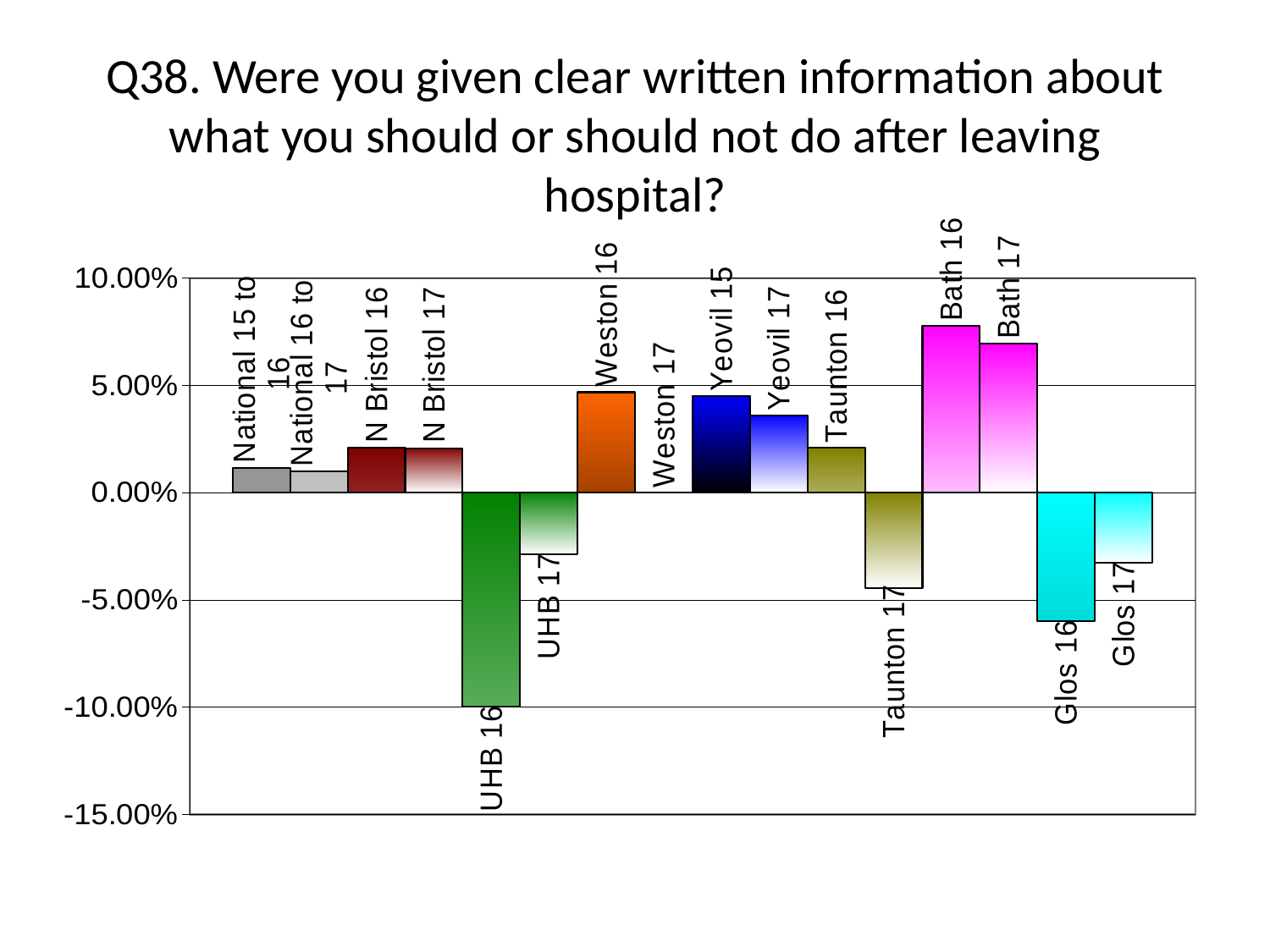
Is the value for Glos 16 greater or less than -5.00%? less Is the value for UHB 17 greater or less than 0.00%? less Is the value for Bath 16 greater or less than 5.00%? greater Which is larger, the value for Bath 17 or the value for N Bristol 17? Bath 17 What is the title of the chart? Q38. Were you given clear written information about what you should or should not do after leaving hospital? How many categories (bars) are plotted on the chart? 16 Which is lower, the value for UHB 16 or the value for Taunton 17? UHB 16 Which category has the highest value on the chart? Bath 16 Which category has the lowest value on the chart? UHB 16 Which is larger, the value for Weston 16 or the value for Yeovil 17? Weston 16 What kind of chart is shown on the slide? bar chart